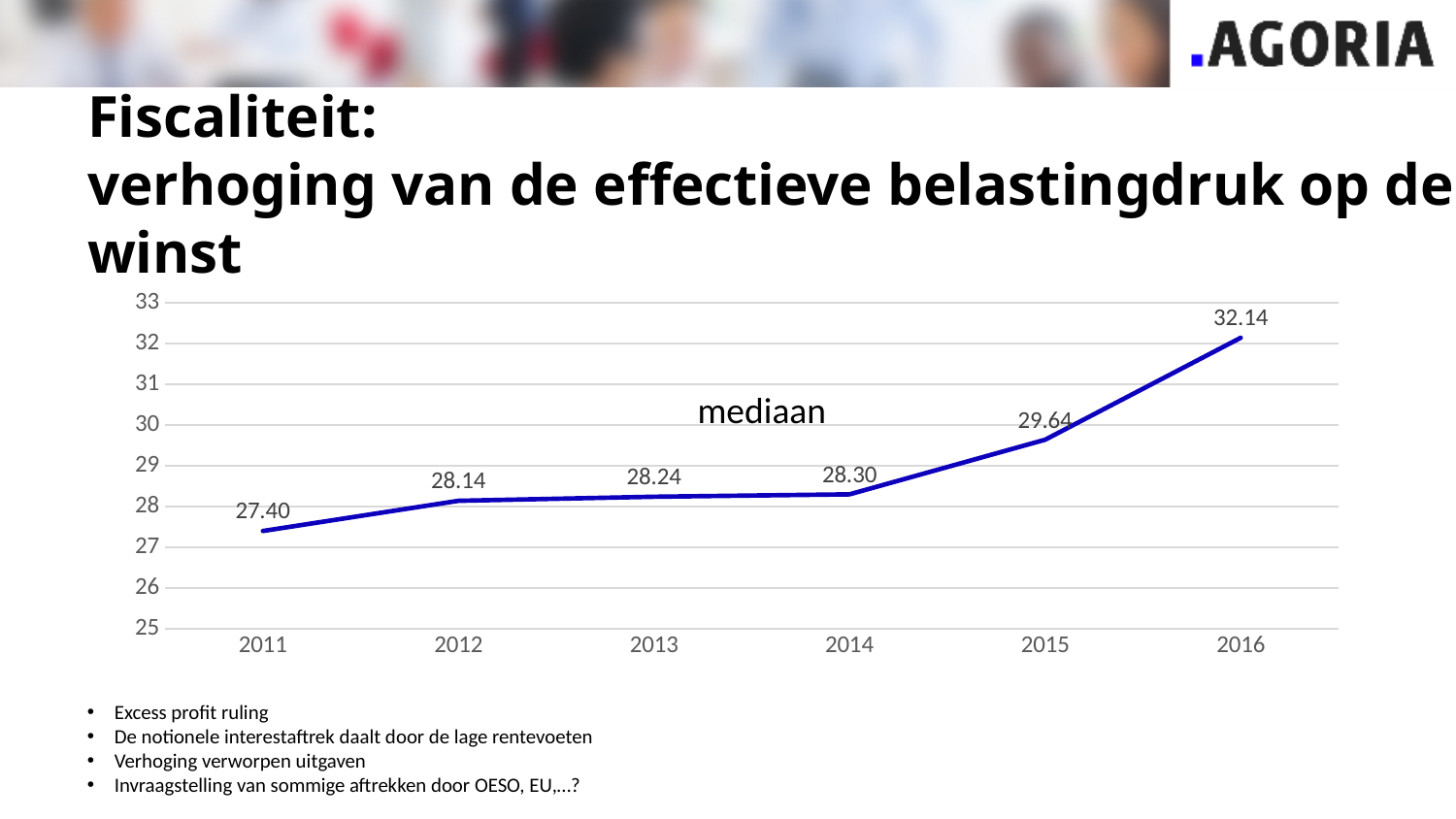
How many years are plotted on the chart? 6 What kind of chart is shown on the slide? line chart What is the difference between the values for 2016 and 2015? 2.50 What is the value for 2016? 32.14 Do the values rise or fall from 2011 to 2016? rise What is the value for 2011? 27.40 Which is larger, the value for 2015 or the value for 2013? 2015 What is the difference between the values for 2012 and 2011? 0.74 Which year has the highest value? 2016 Is the value for 2015 greater or less than 29? greater Which year has the lowest value? 2011 What is the value for 2014? 28.30